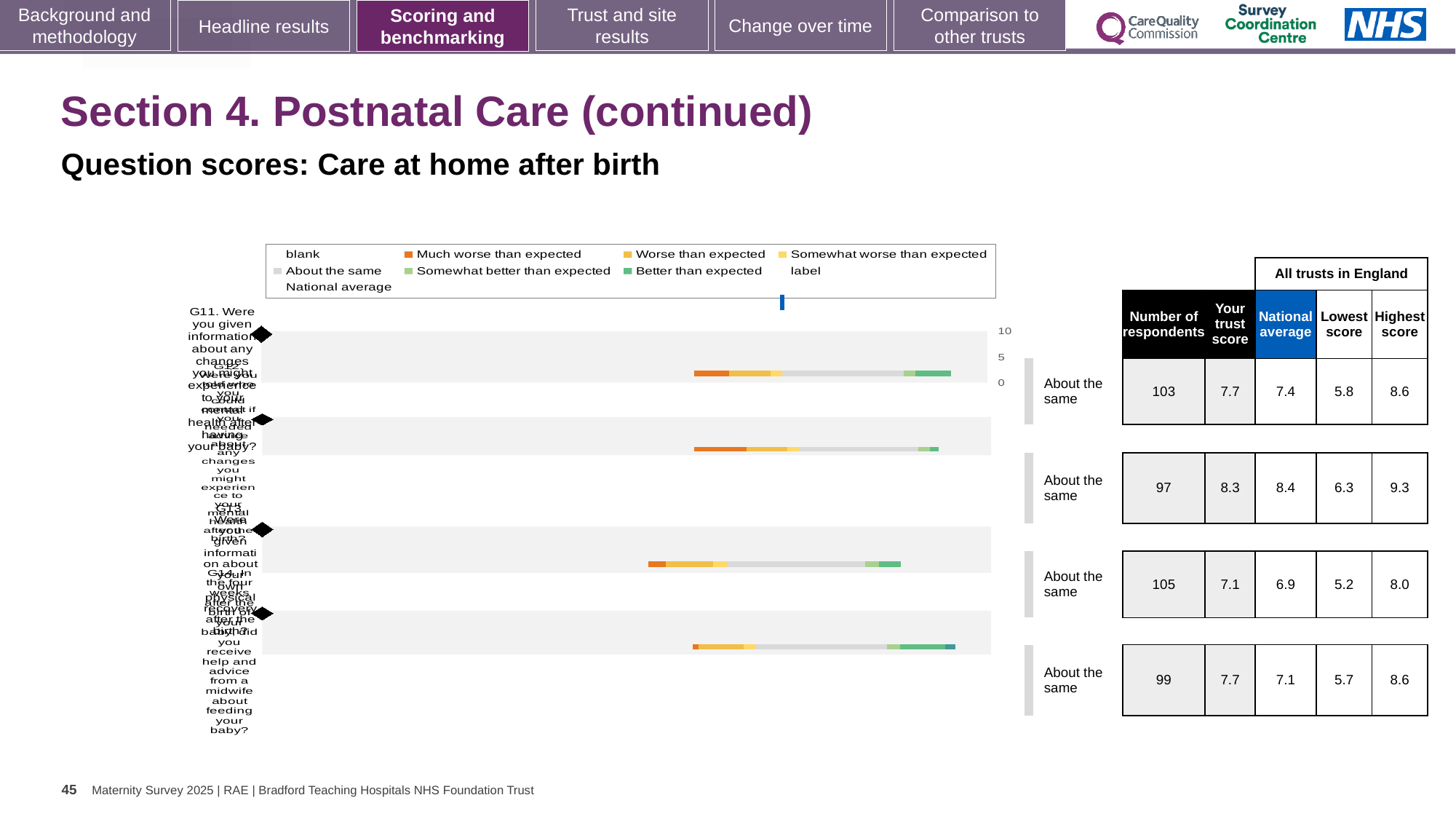
In the table, what is the National average for the row with 97 respondents? 8.4 What is the lowest 'Your trust score' shown in the table? 7.1 Which row has the highest 'Your trust score' in the table? the second row (97 respondents), 8.3 For the second row (97 respondents), which is larger: 'Your trust score' or the National average? National average In the table, what is the 'Your trust score' for the first row (103 respondents)? 7.7 What benchmark category is shown next to each of the four bars? About the same What kind of chart is shown on the slide? bar chart For the fourth row (99 respondents), what is the difference between 'Your trust score' and the National average? 0.6 Which colour in the legend represents 'Much worse than expected'? orange What is the Highest score for the row with 105 respondents? 8.0 What is the Lowest score for the row with 105 respondents? 5.2 How many question bars are plotted in the chart? 4